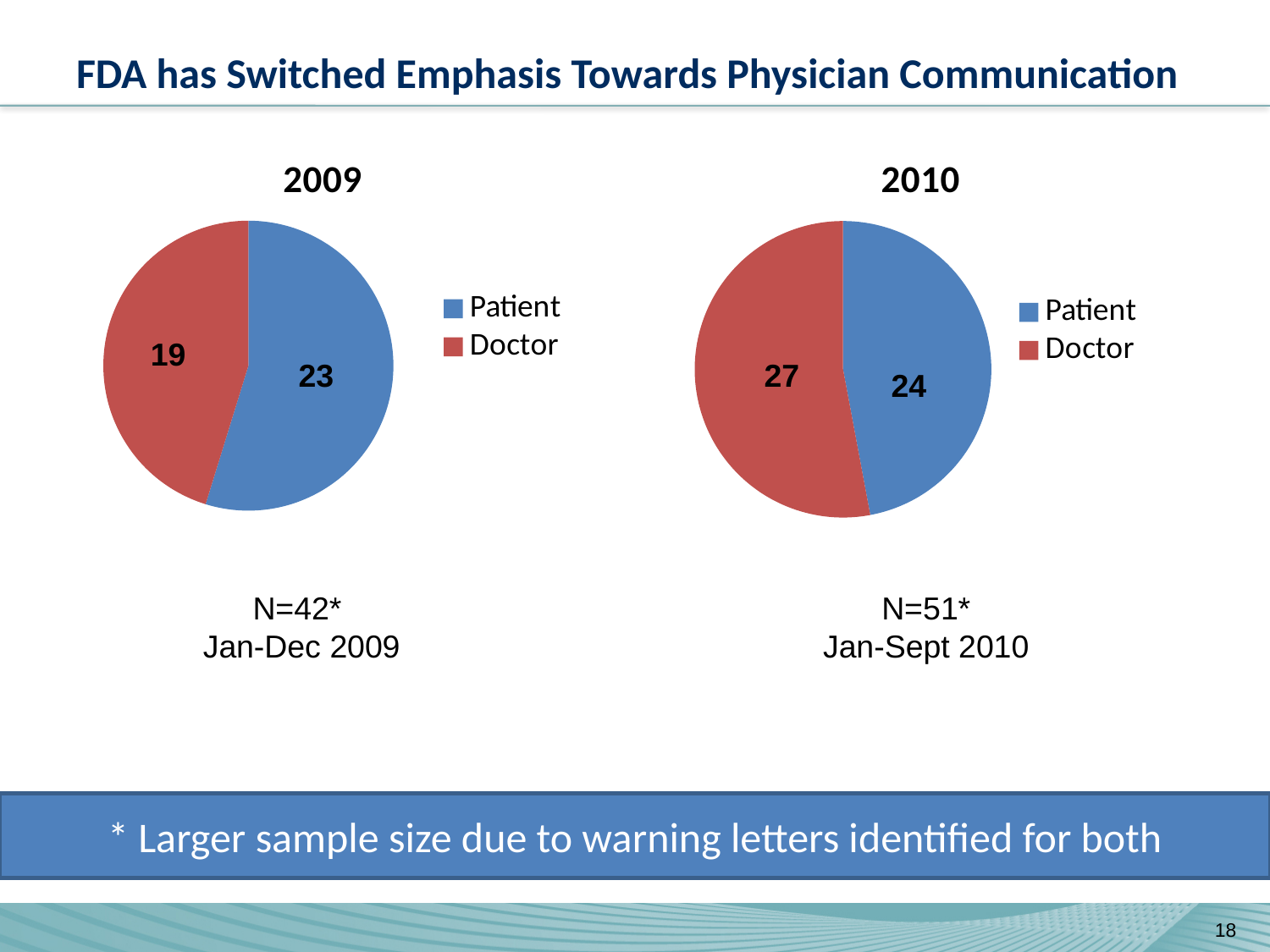
What type of chart is the 2010 chart? Pie chart In the 2010 pie chart, which category has the larger slice? Doctor Is the Doctor value larger in the 2009 pie chart or the 2010 pie chart? 2010 In the 2010 pie chart, what is the difference between the Doctor and Patient values? 3 In the 2009 pie chart, what is the value for Patient? 23 In the 2009 pie chart, what is the value for Doctor? 19 In the 2009 pie chart, what is the difference between the Patient and Doctor values? 4 How many categories does the legend of the 2009 pie chart list? 2 In the 2010 pie chart, what colour is the Doctor slice? Red In the 2010 pie chart, what is the value for Patient? 24 In the 2010 pie chart, what is the value for Doctor? 27 In the 2009 pie chart, which category has the larger slice? Patient